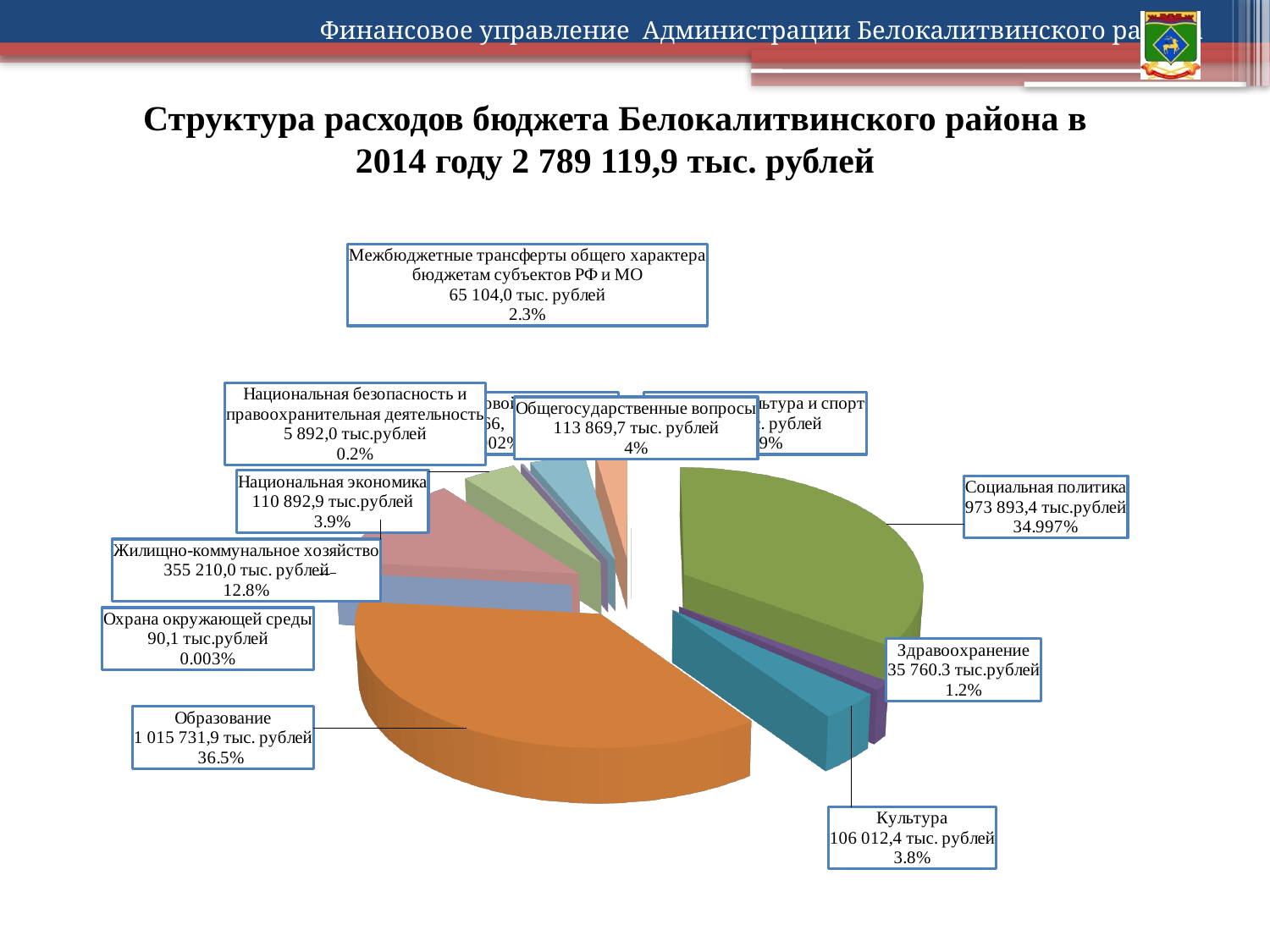
What is the value for Межбюджетные трансферты общего характера бюджетам субъектов РФ и МО in thousand rubles? 65 104,0 тыс. рублей What share of the budget expenditure does Образование account for? 36.5% What is the difference in percentage points between Жилищно-коммунальное хозяйство and Национальная экономика? 8.9% What percentage is shown for Здравоохранение? 1.2% What kind of chart is shown on the slide? Pie chart According to the chart title, what is the total budget expenditure of Белокалитвинский район in 2014? 2 789 119,9 тыс. рублей Which has a larger share: Общегосударственные вопросы or Культура? Общегосударственные вопросы What is the value for Социальная политика in thousand rubles? 973 893,4 тыс.рублей What is the value for Жилищно-коммунальное хозяйство in thousand rubles? 355 210,0 тыс. рублей What is the difference in percentage points between Образование and Социальная политика? 1.503% Which category has the largest share of expenditure? Образование